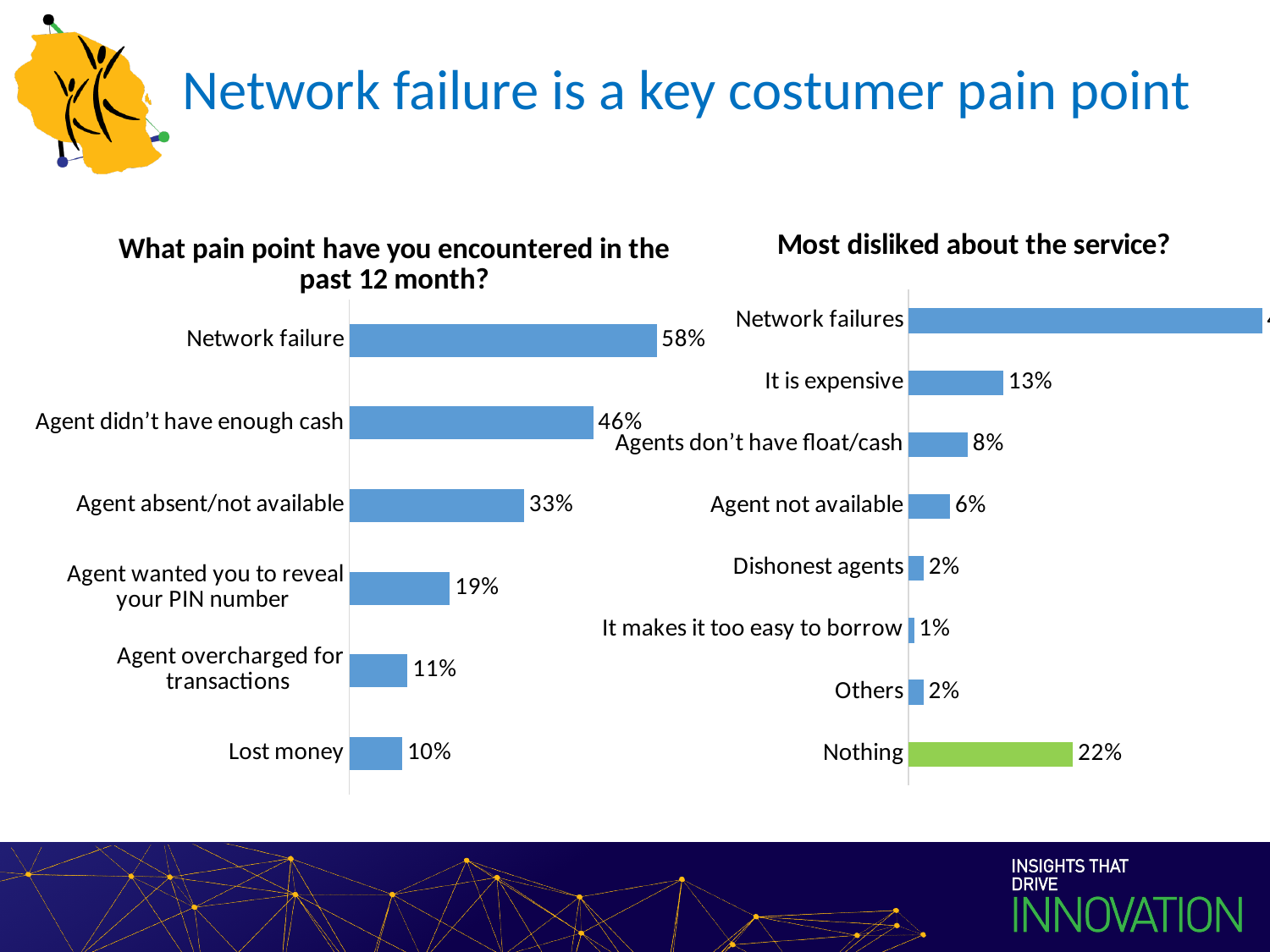
In the chart 'Most disliked about the service?', which category has the highest value? Network failures In the chart 'Most disliked about the service?', what is the value for Nothing? 22% In the chart 'What pain point have you encountered in the past 12 month?', which category has the lowest value? Lost money In the chart 'What pain point have you encountered in the past 12 month?', what is the difference between Network failure and Agent didn't have enough cash? 12% In the chart 'What pain point have you encountered in the past 12 month?', what is the value for Agent absent/not available? 33% In the chart 'Most disliked about the service?', how many categories are shown? 8 In the chart 'Most disliked about the service?', which is larger: Agents don't have float/cash or Agent not available? Agents don't have float/cash In the chart 'Most disliked about the service?', which category has the lowest value? It makes it too easy to borrow What type of chart is 'Most disliked about the service?' Bar chart In the chart 'What pain point have you encountered in the past 12 month?', what is the value for Network failure? 58% In the chart 'Most disliked about the service?', what is the value for It is expensive? 13% In the chart 'What pain point have you encountered in the past 12 month?', how many categories are shown? 6